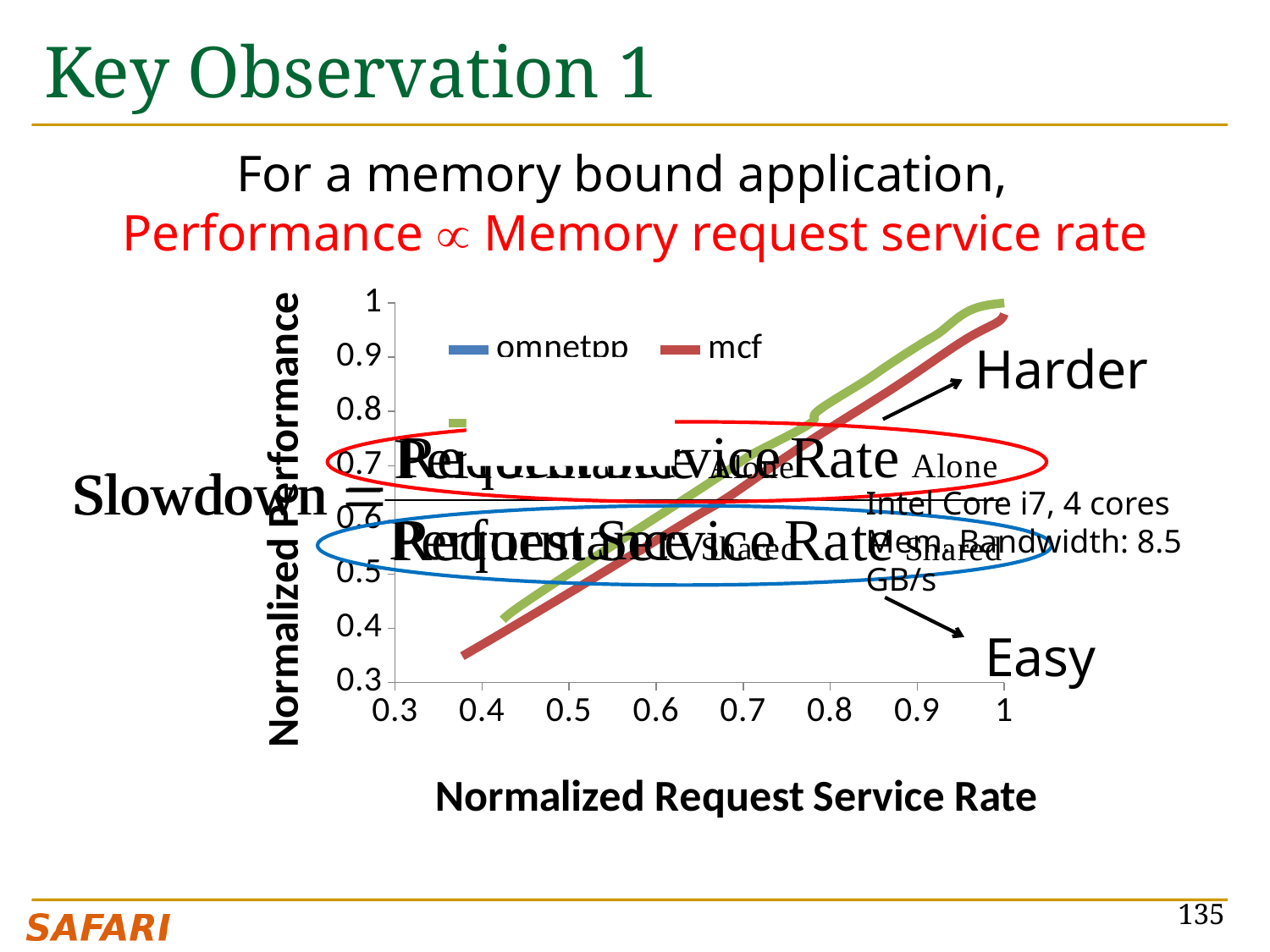
Is the Normalized Performance of mcf at a Normalized Request Service Rate of 0.7 greater or less than 0.8? less Is the Normalized Performance of mcf at a Normalized Request Service Rate of 0.4 greater or less than 0.5? less What is the title of the chart's x axis? Normalized Request Service Rate Which two series are listed in the chart legend? omnetpp and mcf Do the plotted lines rise or fall as Normalized Request Service Rate increases? rise What is the lowest value shown on the y axis of the chart? 0.3 How many series does the chart legend list? 2 Is the Normalized Performance of mcf at a Normalized Request Service Rate of 1 greater or less than 0.9? greater What kind of chart is shown on the slide? line chart What is the highest value shown on the x axis of the chart? 1